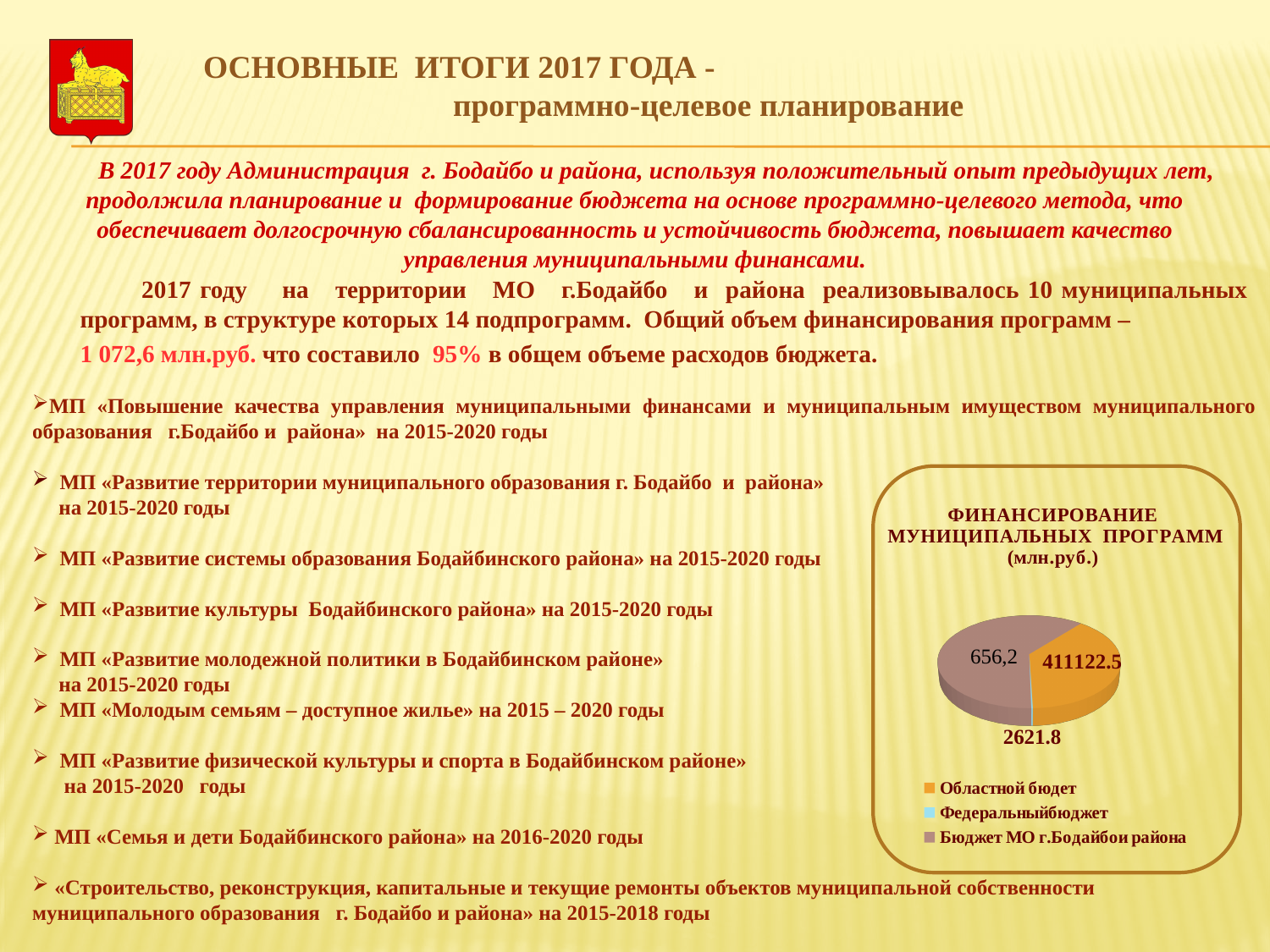
Which category has the smallest slice in the pie chart? Федеральныйбюджет What value is printed on the slice for Бюджет МО г.Бодайбои района? 656,2 Which category has the largest slice in the pie chart? Бюджет МО г.Бодайбои района What kind of chart is shown on the slide? pie chart How many slices (categories) does the pie chart have? 3 What is the title of the chart on the slide? ФИНАНСИРОВАНИЕ МУНИЦИПАЛЬНЫХ ПРОГРАММ (млн.руб.) Which slice is larger: Областной бюдет or Бюджет МО г.Бодайбои района? Бюджет МО г.Бодайбои района What colour represents Областной бюдет in the pie chart? orange In what units are the values of the chart given, according to its title? млн.руб. How many entries does the chart legend list? 3